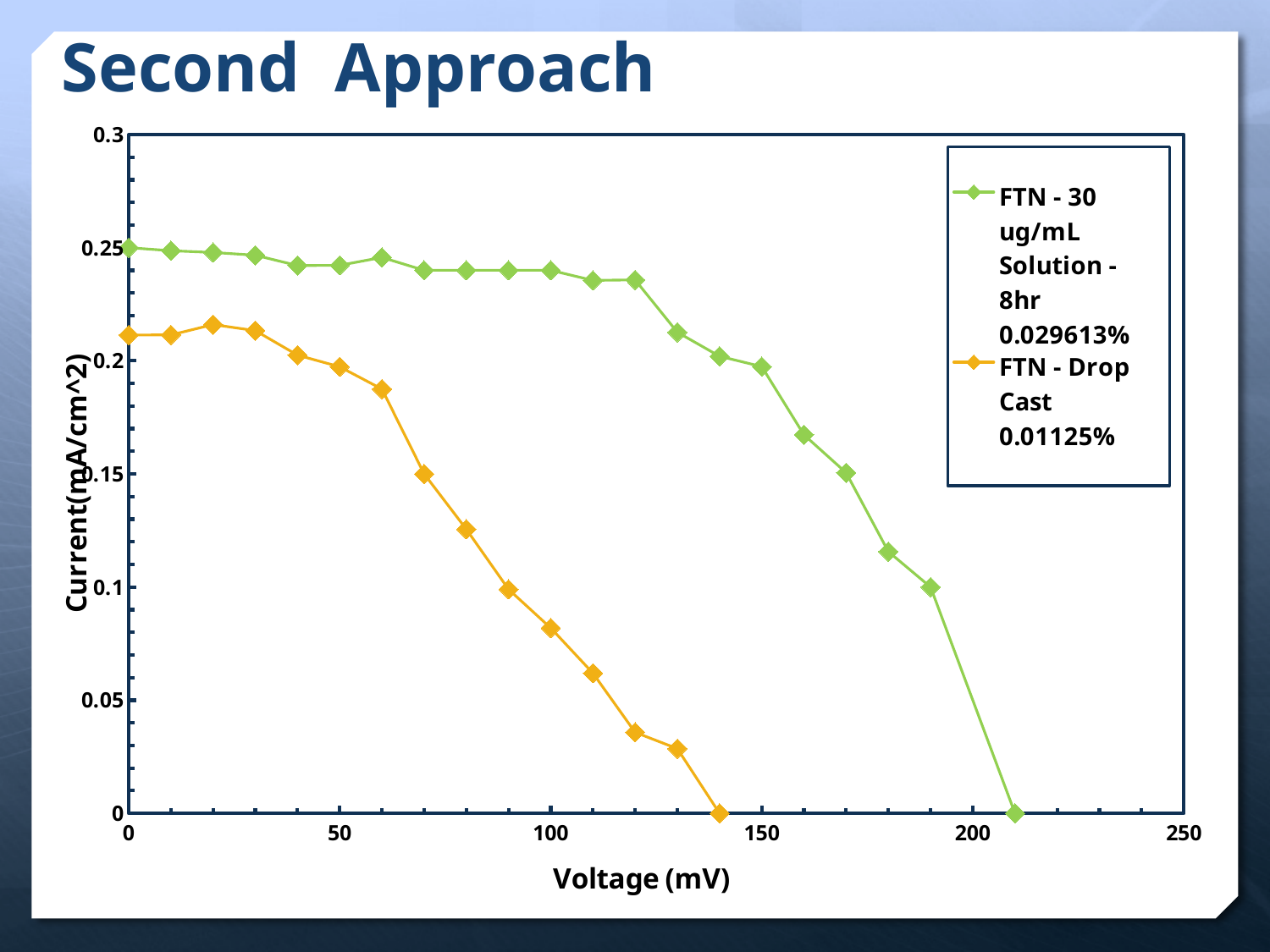
At what voltage does the FTN - Drop Cast 0.01125% series reach a current of 0? 140 mV At what voltage does the FTN - 30 ug/mL Solution - 8hr 0.029613% series reach a current of 0? 210 mV How many series does the legend list? 2 Which series is plotted in orange? FTN - Drop Cast 0.01125% What is the label of the x axis? Voltage (mV) Is the current for FTN - Drop Cast 0.01125% at 100 mV greater or less than 0.1? less At 100 mV, which series has the higher current? FTN - 30 ug/mL Solution - 8hr 0.029613% Is the current for FTN - Drop Cast 0.01125% at 60 mV greater or less than 0.2? less How many data points are plotted for the FTN - Drop Cast 0.01125% series? 15 Does the current for FTN - Drop Cast 0.01125% rise or fall as voltage increases from 50 mV to 140 mV? Fall What kind of chart is shown on the slide? Line chart Is the current for FTN - 30 ug/mL Solution - 8hr 0.029613% at 100 mV greater or less than 0.2? greater